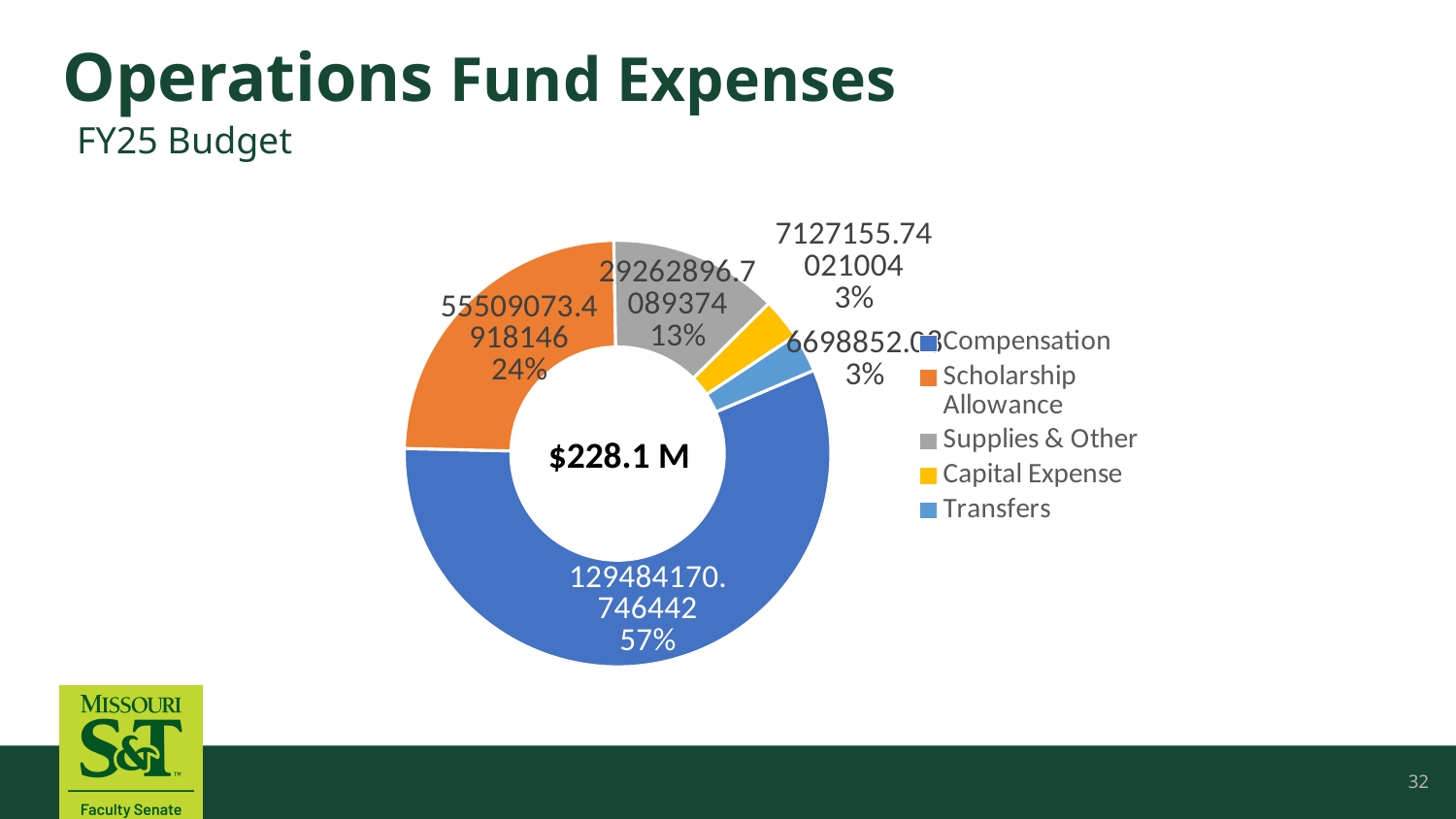
What total amount is shown in the centre of the chart? $228.1 M What share of Operations Fund Expenses is Capital Expense? 3% What share of Operations Fund Expenses is Supplies & Other? 13% What is the value labelled for Scholarship Allowance? 55509073.4918146 What share of Operations Fund Expenses is Compensation? 57% Which is larger, the share for Scholarship Allowance or the share for Supplies & Other? Scholarship Allowance What is the difference in percentage points between the Compensation share and the Scholarship Allowance share? 33 percentage points What kind of chart is shown on the slide? Doughnut (pie) chart How many categories does the chart show? 5 Which category has the largest share of Operations Fund Expenses? Compensation What colour represents Compensation in the chart? Blue